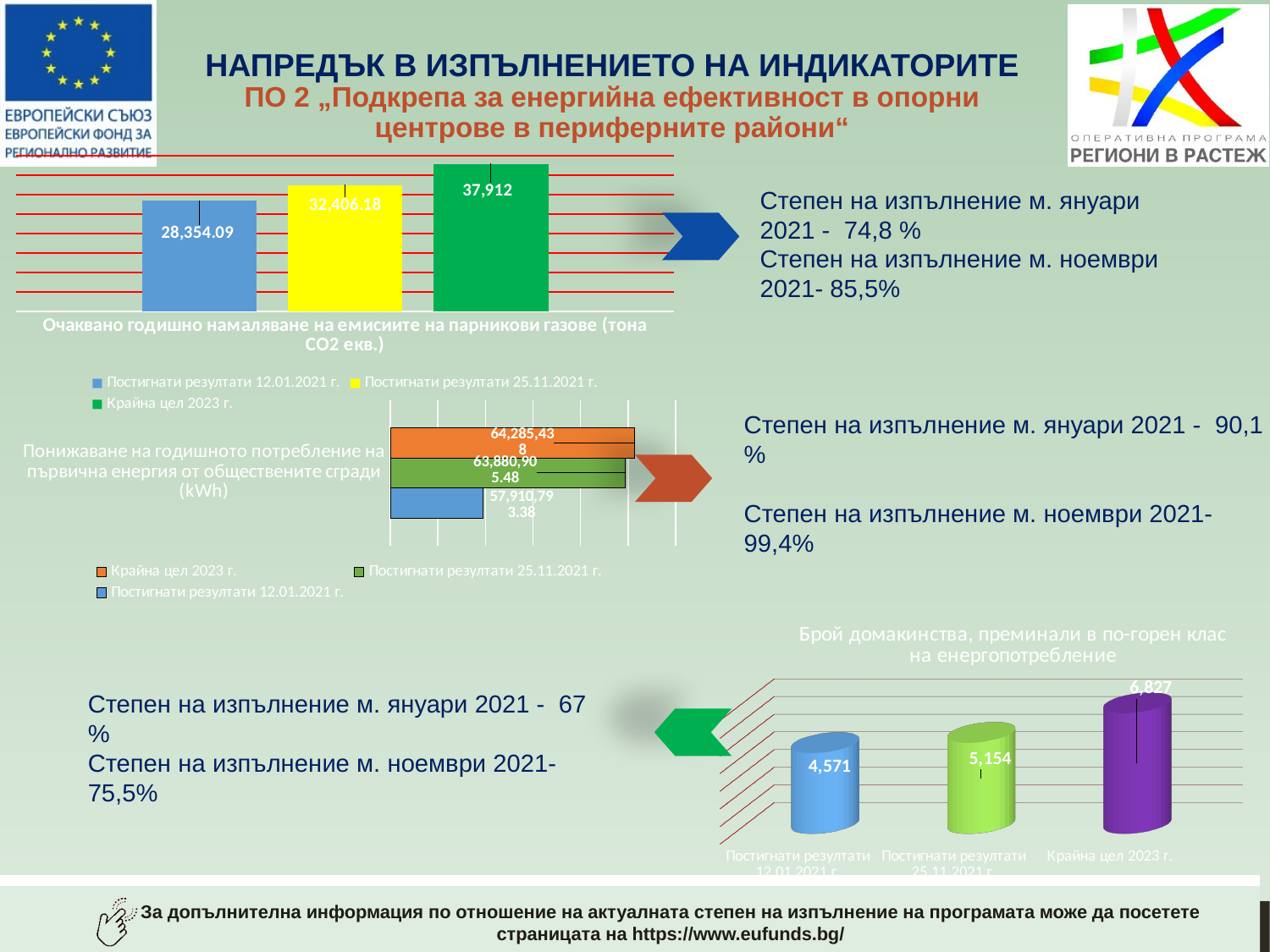
In the chart titled 'Понижаване на годишното потребление на първична енергия от обществените сгради (kWh)', which series has the shortest bar? Постигнати резултати 12.01.2021 г. In the chart titled 'Брой домакинства, преминали в по-горен клас на енергопотребление', what is the value for 'Постигнати резултати 25.11.2021 г.'? 5,154 In the chart titled 'Очаквано годишно намаляване на емисиите на парникови газове (тона CO2 екв.)', what is the value for 'Постигнати резултати 12.01.2021 г.'? 28,354.09 What kind of chart is the one titled 'Понижаване на годишното потребление на първична енергия от обществените сгради (kWh)'? bar chart In the chart titled 'Понижаване на годишното потребление на първична енергия от обществените сгради (kWh)', which series has the longest bar? Крайна цел 2023 г. In the chart titled 'Очаквано годишно намаляване на емисиите на парникови газове (тона CO2 екв.)', what is the value for 'Крайна цел 2023 г.'? 37,912 In the chart titled 'Брой домакинства, преминали в по-горен клас на енергопотребление', do the values rise or fall from left to right? rise In the chart titled 'Очаквано годишно намаляване на емисиите на парникови газове (тона CO2 екв.)', what is the value for 'Постигнати резултати 25.11.2021 г.'? 32,406.18 In the chart titled 'Брой домакинства, преминали в по-горен клас на енергопотребление', what is the difference between 'Крайна цел 2023 г.' and 'Постигнати резултати 12.01.2021 г.'? 2,256 In the chart titled 'Очаквано годишно намаляване на емисиите на парникови газове (тона CO2 екв.)', what is the difference between 'Крайна цел 2023 г.' and 'Постигнати резултати 12.01.2021 г.'? 9,557.91 In the chart titled 'Очаквано годишно намаляване на емисиите на парникови газове (тона CO2 екв.)', how many series does the legend list? 3 In the chart titled 'Брой домакинства, преминали в по-горен клас на енергопотребление', what is the value for 'Крайна цел 2023 г.'? 6,827